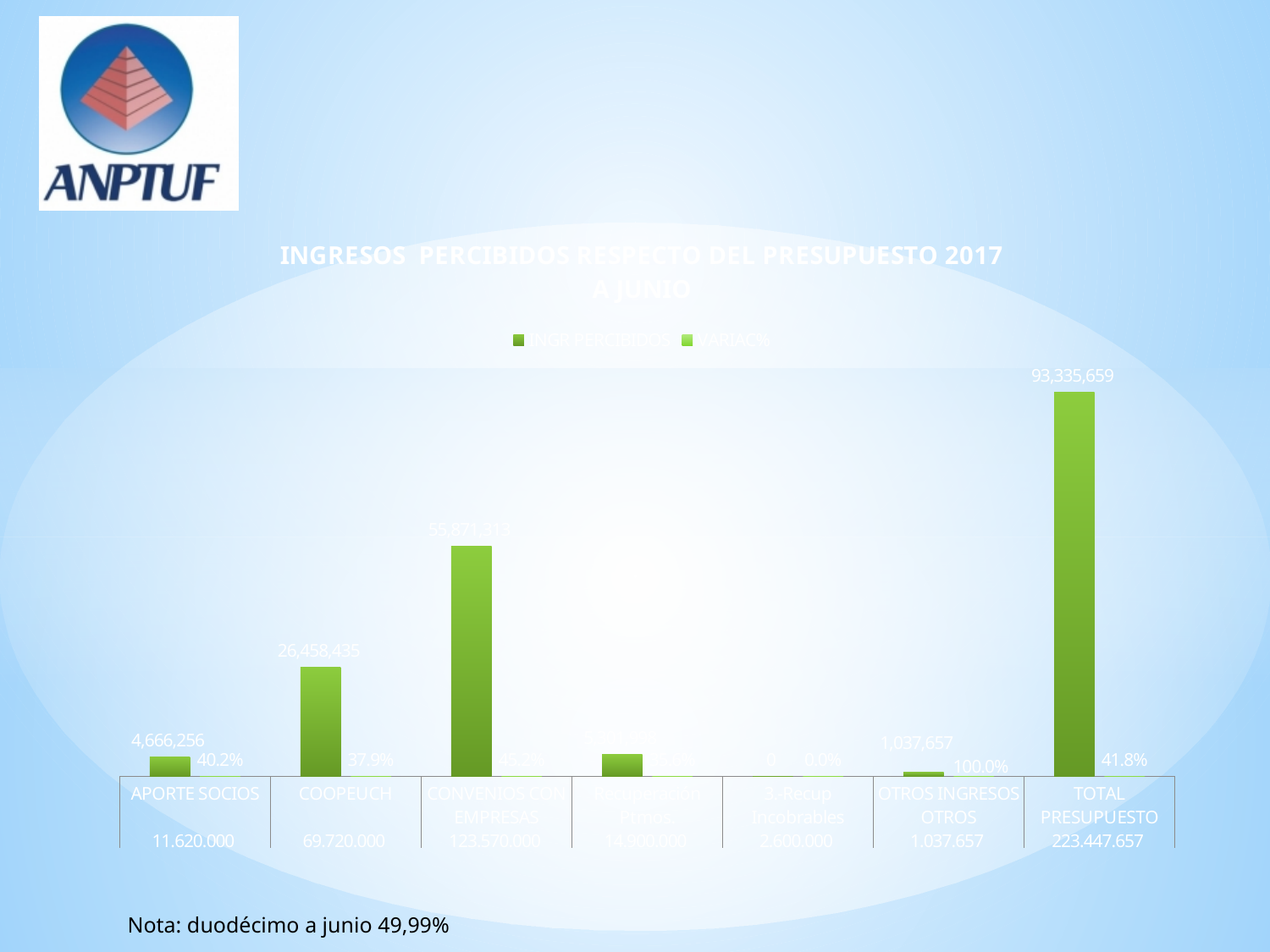
What is the INGR PERCIBIDOS value for 3.-Recup Incobrables? 0 Which category has the highest INGR PERCIBIDOS bar? TOTAL PRESUPUESTO What kind of chart is shown on the slide? Bar chart What is the INGR PERCIBIDOS value for COOPEUCH? 26,458,435 How many series does the legend list? 2 What is the INGR PERCIBIDOS value for APORTE SOCIOS? 4,666,256 What is the difference between the INGR PERCIBIDOS values for COOPEUCH and APORTE SOCIOS? 21,792,179 What is the VARIAC% value for COOPEUCH? 37.9% What is the VARIAC% value for TOTAL PRESUPUESTO? 41.8% Which is larger, the INGR PERCIBIDOS value for COOPEUCH or for APORTE SOCIOS? COOPEUCH What is the VARIAC% value for OTROS INGRESOS OTROS? 100.0% What is the INGR PERCIBIDOS value for TOTAL PRESUPUESTO? 93,335,659